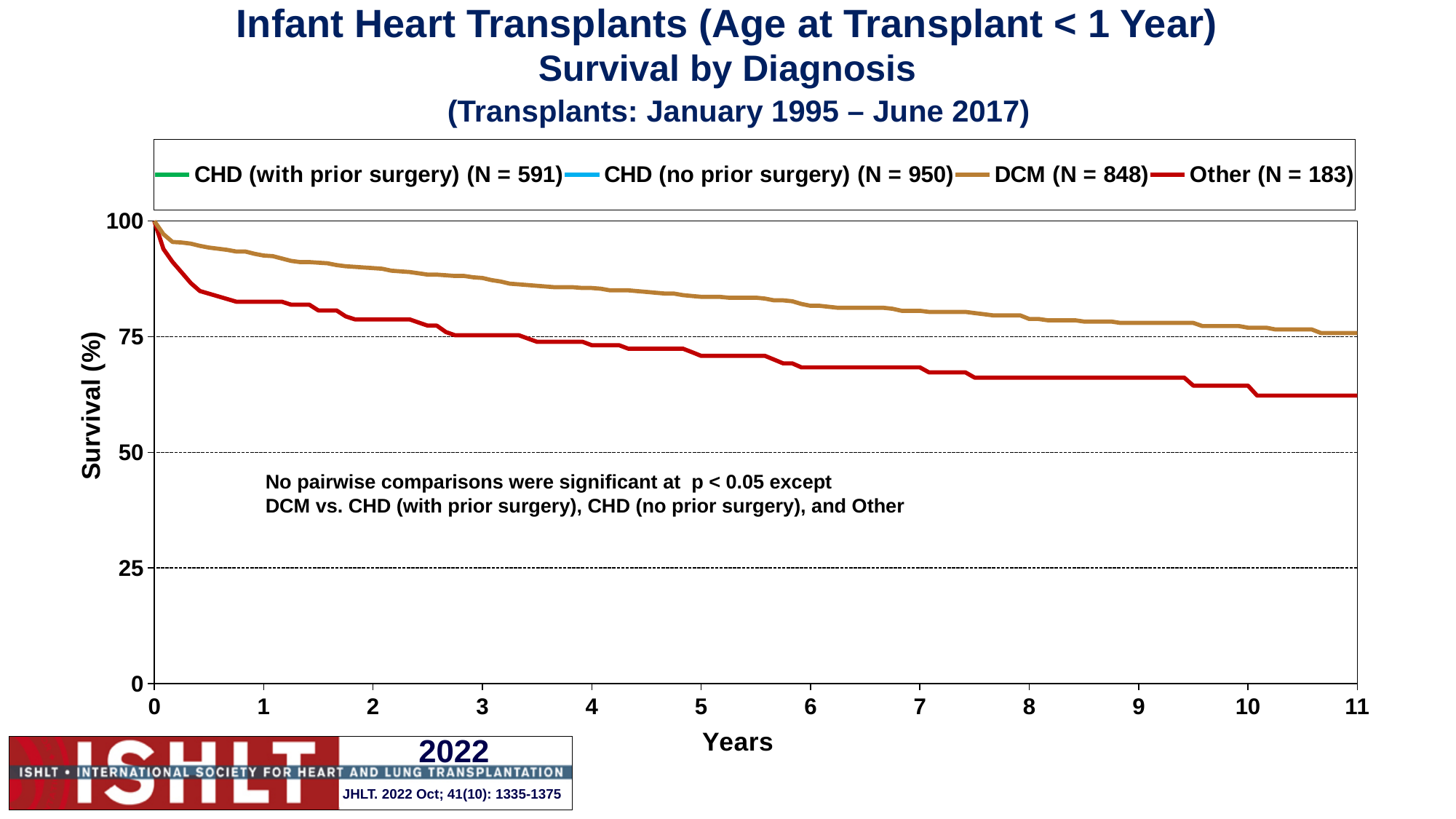
How many series does the legend list? 4 Is the survival value for DCM at year 5 greater or less than 75? greater Does the survival for the Other group rise or fall as years increase? fall What is the N for the DCM group shown in the legend? 848 What is the label on the y axis? Survival (%) Is the survival value for DCM at year 2 greater or less than 75? greater At year 5, which line is higher, DCM or Other? DCM What is the survival value for the DCM line at year 0? 100 Is the survival value for Other at year 11 greater or less than 75? less What kind of chart is shown on the slide? line chart Which plotted line has the lowest survival at year 11? Other